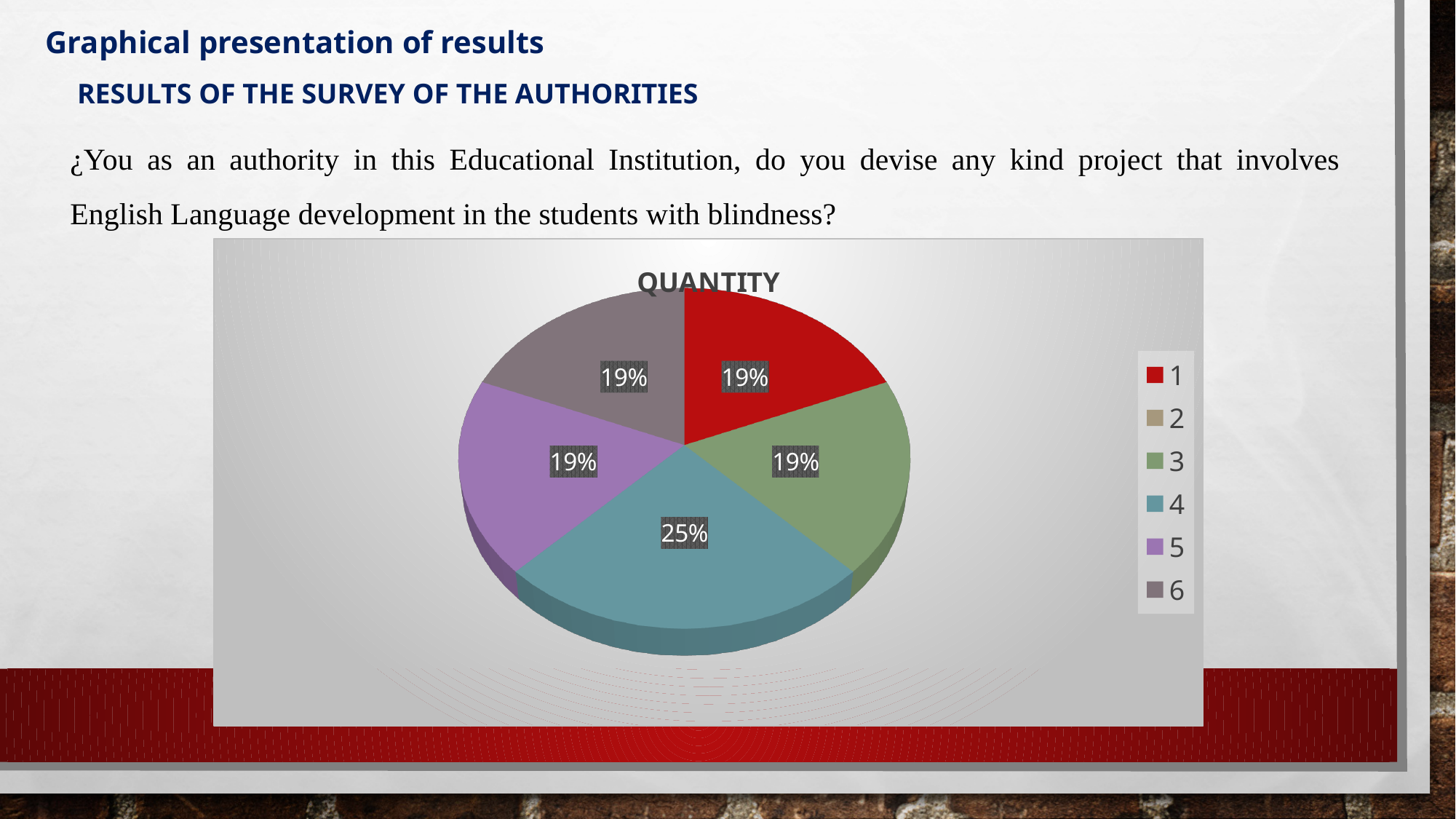
What percentage is shown for category 6? 19% What is the title of the chart? QUANTITY What percentage is shown for category 5? 19% What share of the pie does category 4 represent? 25% What percentage is shown for category 3? 19% What is the difference in percentage points between category 4 and category 1? 6% How many slices of the pie are labelled with a percentage? 5 What kind of chart is shown on the slide? pie chart How many entries does the chart's legend list? 6 Which is larger, the slice for category 4 or the slice for category 5? 4 What share of the pie does category 1 represent? 19% Which category has the largest slice of the pie? 4